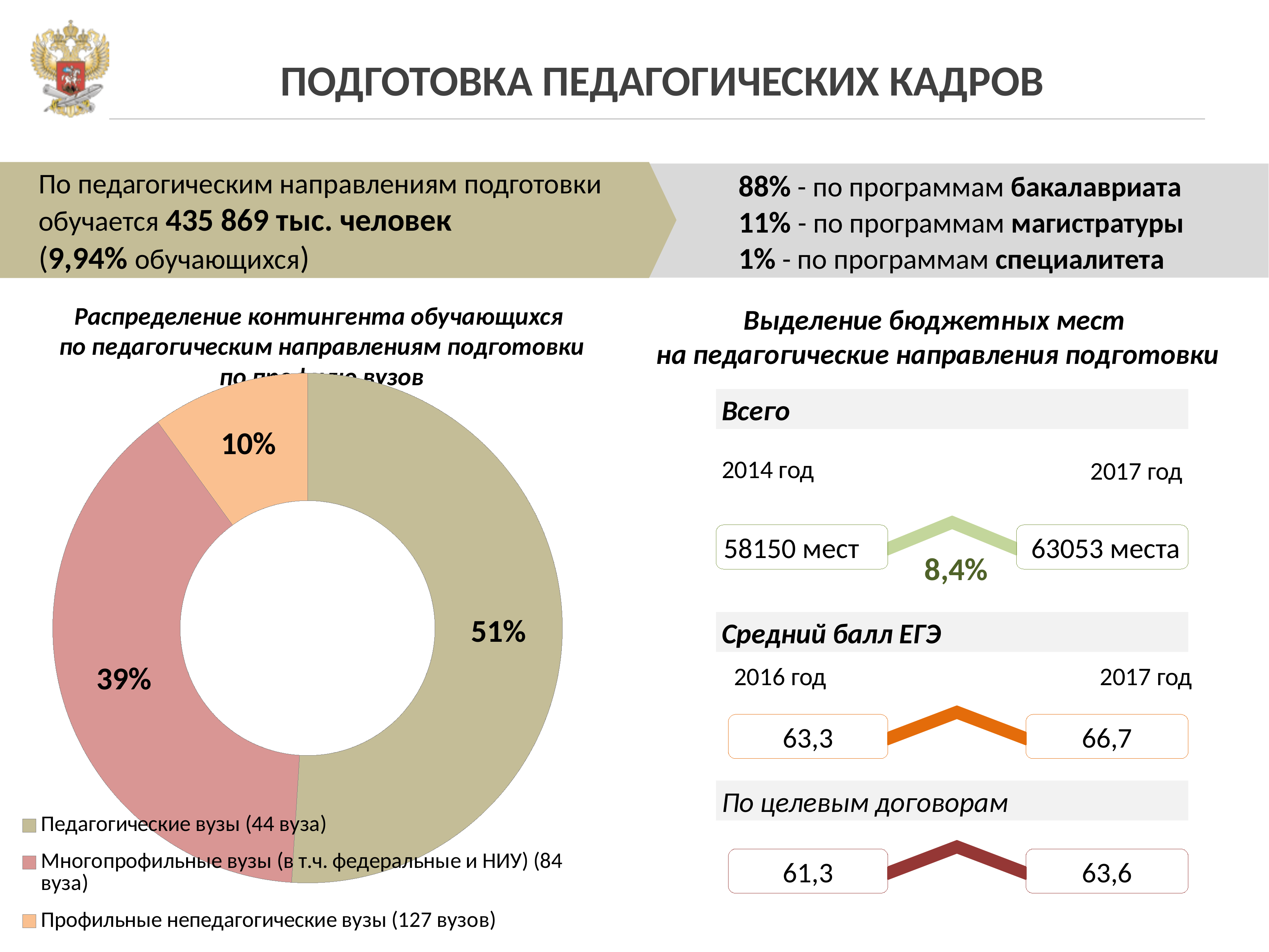
In the donut chart, what share is shown for Многопрофильные вузы (в т.ч. федеральные и НИУ) (84 вуза)? 39% According to the legend of the donut chart, how many universities are in the Профильные непедагогические вузы category? 127 вузов Which category has the largest slice in the donut chart? Педагогические вузы (44 вуза) In the donut chart, what is the difference in percentage points between Педагогические вузы and Многопрофильные вузы? 12 In the donut chart, what colour is the slice for Многопрофильные вузы? Pink (rose) How many entries does the legend of the donut chart list? 3 In the donut chart, what share is shown for Педагогические вузы (44 вуза)? 51% In the donut chart, what share is shown for Профильные непедагогические вузы (127 вузов)? 10% Which category has the smallest slice in the donut chart? Профильные непедагогические вузы (127 вузов) How many slices does the donut chart have? 3 What kind of chart is shown on the left of the slide? Pie (donut) chart In the donut chart, which slice is larger: Многопрофильные вузы or Профильные непедагогические вузы? Многопрофильные вузы